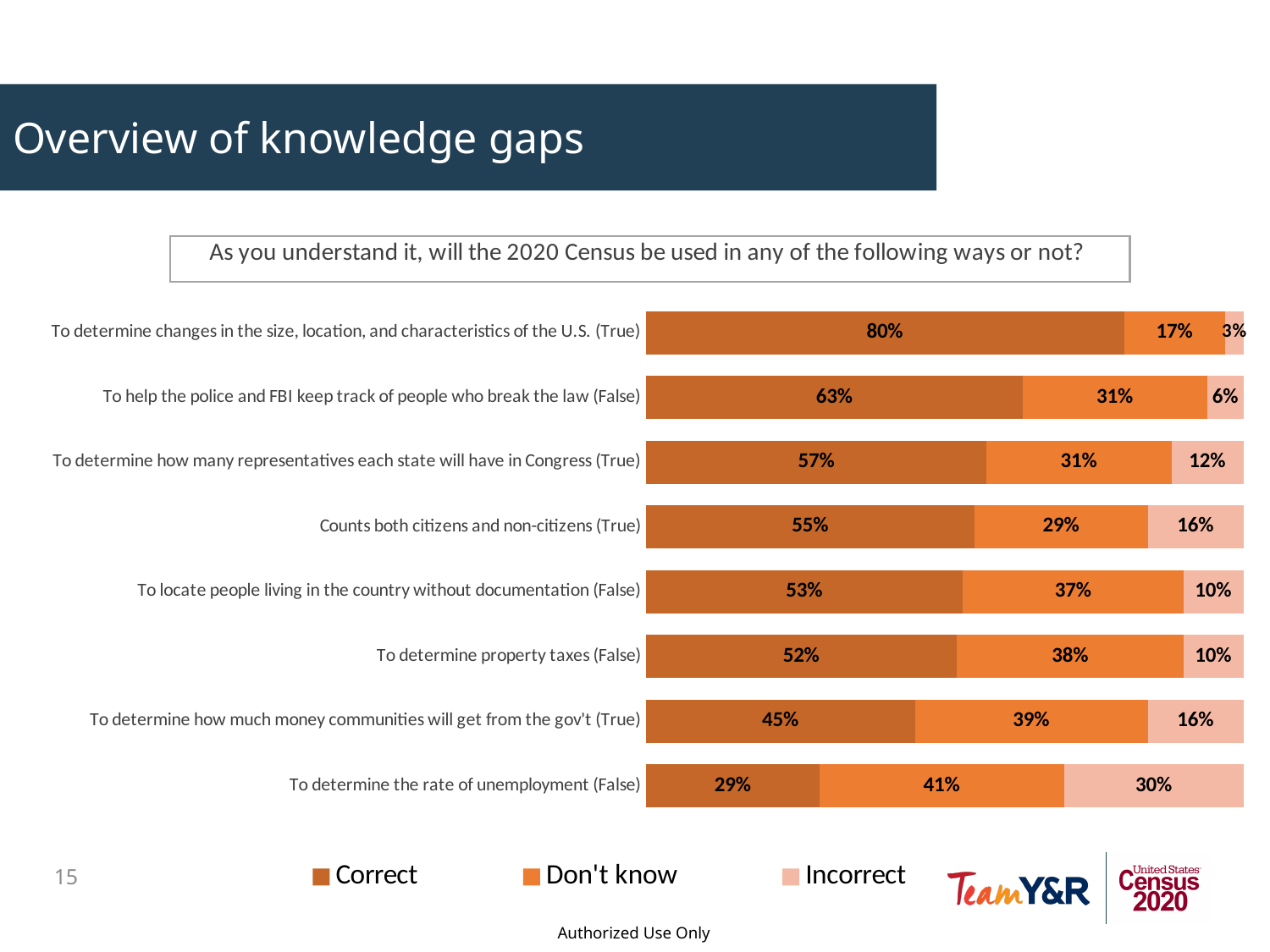
What kind of chart is shown on the slide? Stacked bar chart Which statement has the highest Correct percentage? To determine changes in the size, location, and characteristics of the U.S. (True) How many statements are shown in the chart? 8 Which statement has the lowest Correct percentage? To determine the rate of unemployment (False) Which is larger: the Don't know value for "To determine property taxes (False)" or for "To locate people living in the country without documentation (False)"? To determine property taxes (False) How many series does the legend list? 3 What is the total of the three segments for "Counts both citizens and non-citizens (True)"? 100% What is the difference between the Correct percentages for "To help the police and FBI keep track of people who break the law (False)" and "To determine property taxes (False)"? 11% What percentage answered Correct for "To determine changes in the size, location, and characteristics of the U.S. (True)"? 80% What is the Don't know value for "To determine the rate of unemployment (False)"? 41% Which statement has the highest Incorrect percentage? To determine the rate of unemployment (False) What is the Incorrect value for "To determine how many representatives each state will have in Congress (True)"? 12%